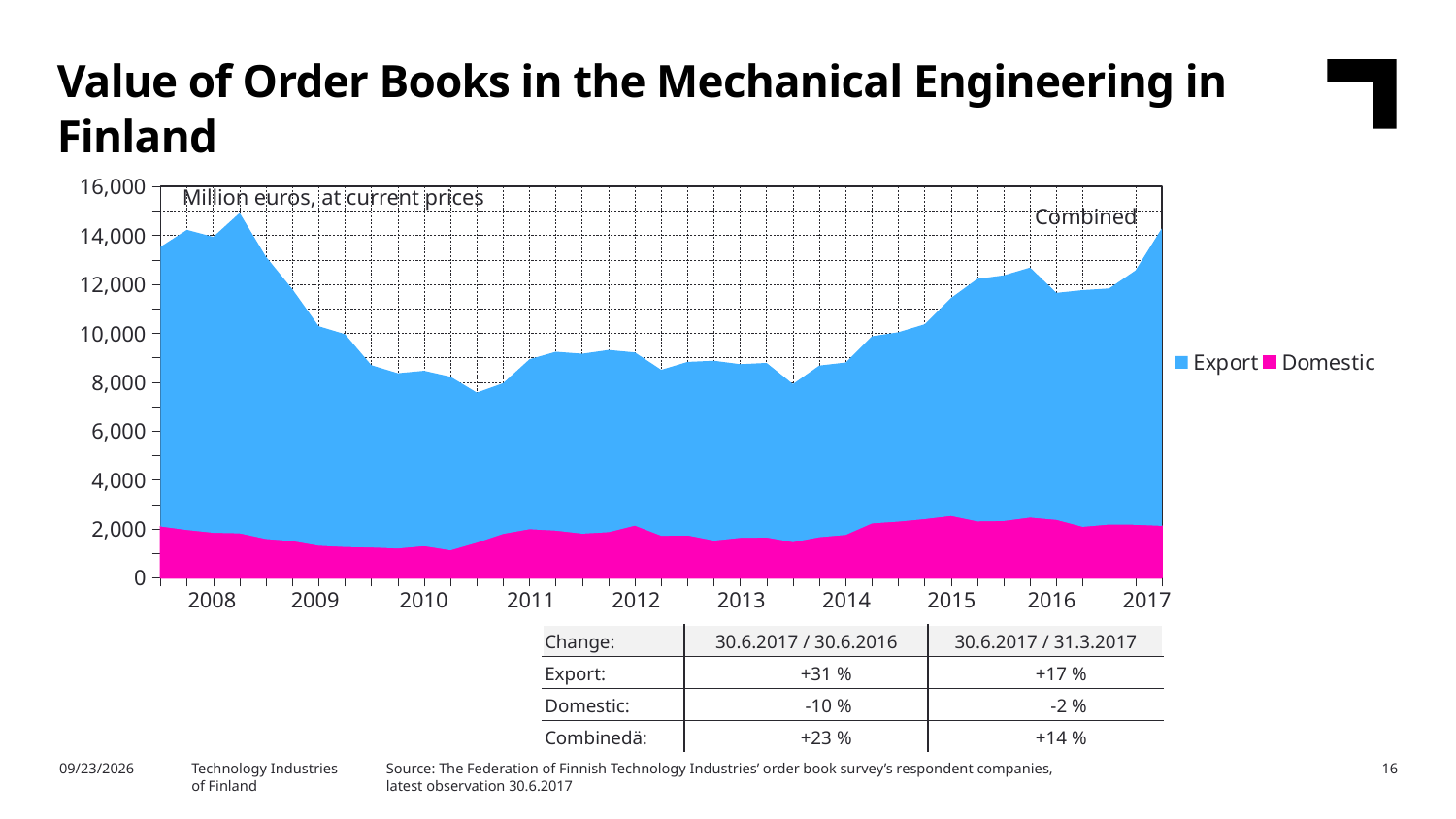
According to the table below the chart, what is the Export change for 30.6.2017 / 30.6.2016? +31 % Is the combined value of order books at the start of 2008 greater or less than 12,000? greater What unit is stated in the label inside the chart area? Million euros, at current prices What are the two series named in the chart's legend? Export and Domestic How many series does the chart's legend list? 2 Is the combined value of order books in 2013 greater or less than 10,000? less Which series accounts for the larger part of the combined order books, Export or Domestic? Export Does the combined value of order books rise or fall between 2014 and 2016? rise Is the Domestic value of order books in 2010 greater or less than 2,000? less What kind of chart is shown on the slide? Stacked area chart Is the combined value of order books higher in 2008 or in 2013? 2008 Does the combined value of order books rise or fall between 2008 and 2010? fall